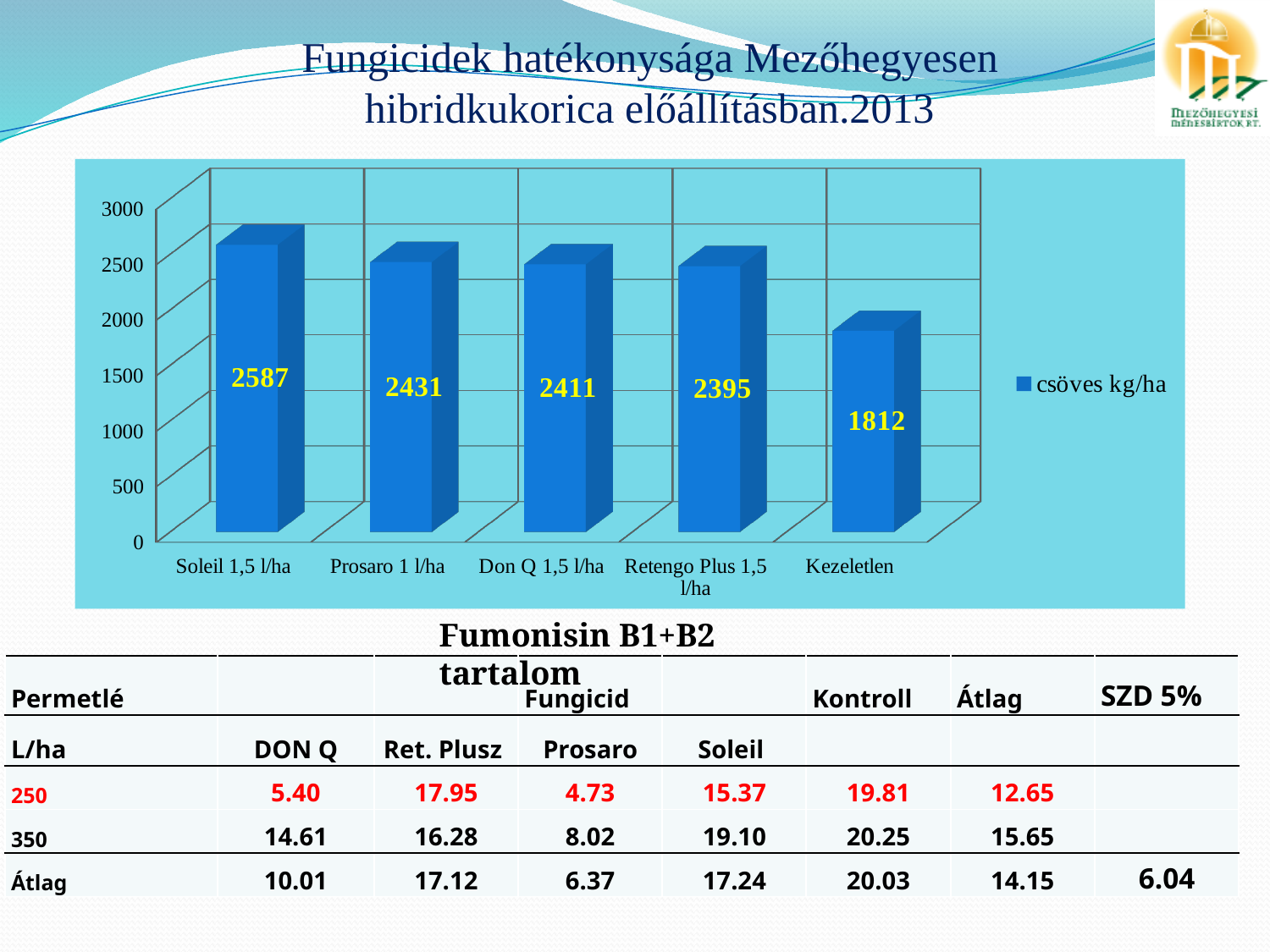
What is the difference between the values for Prosaro 1 l/ha and Don Q 1,5 l/ha? 20 What is the value for Prosaro 1 l/ha in the chart? 2431 What series name does the chart legend show? csöves kg/ha How many categories are shown in the chart? 5 Which category has the highest value in the chart? Soleil 1,5 l/ha What is the value for Soleil 1,5 l/ha in the chart? 2587 What is the value for Retengo Plus 1,5 l/ha in the chart? 2395 What kind of chart is shown on the slide? Bar chart What is the difference between the values for Soleil 1,5 l/ha and Kezeletlen? 775 Which is larger, the value for Don Q 1,5 l/ha or the value for Kezeletlen? Don Q 1,5 l/ha Which category has the lowest value in the chart? Kezeletlen What is the value for Kezeletlen in the chart? 1812